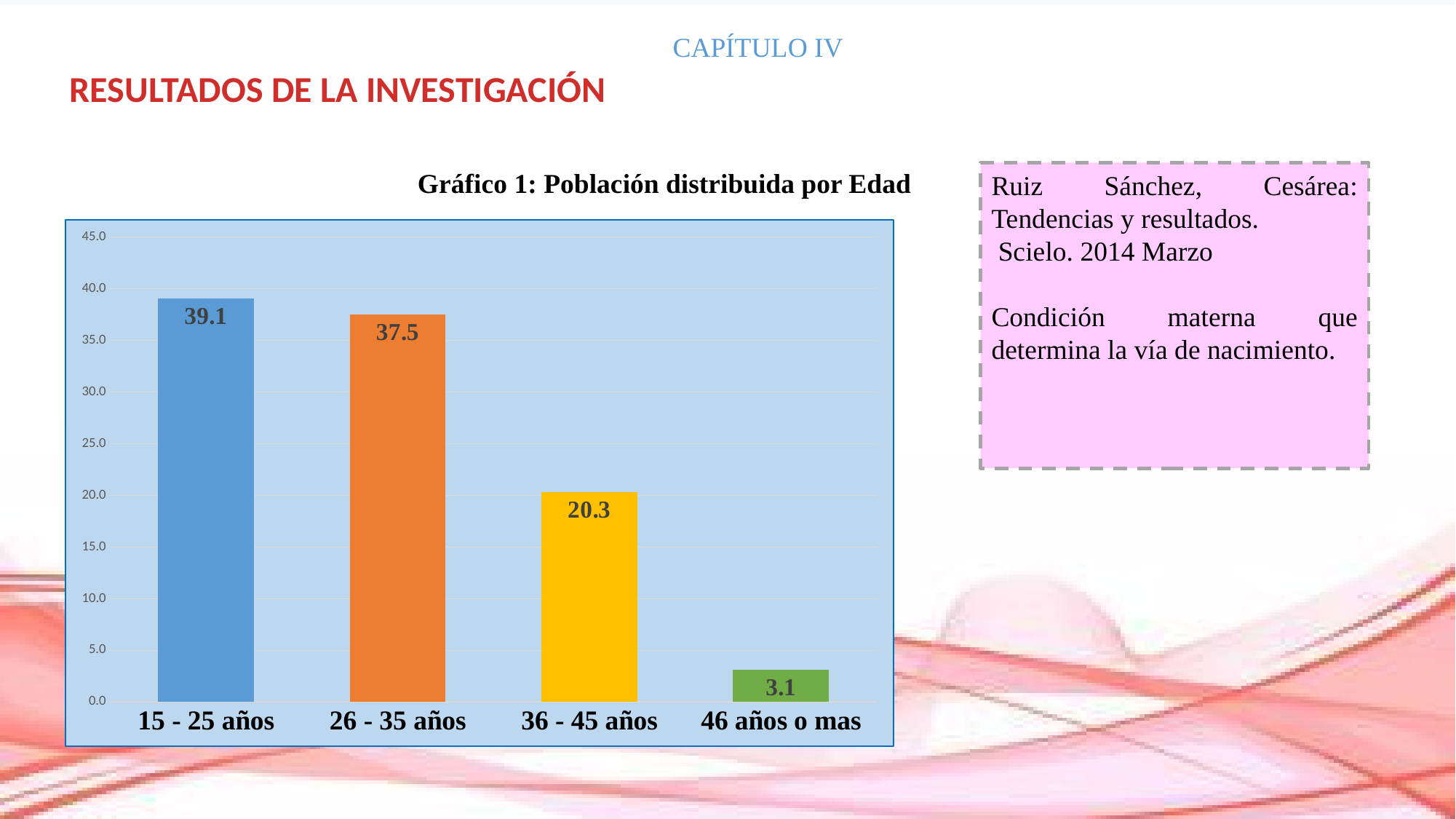
How many age categories are shown in the chart? 4 What is the difference between the values for 36 - 45 años and 46 años o mas? 17.2 What is the difference between the values for 15 - 25 años and 26 - 35 años? 1.6 Which age category has the lowest value? 46 años o mas What kind of chart is shown on the slide? Bar chart What is the title of the chart? Gráfico 1: Población distribuida por Edad Which is larger, the value for 26 - 35 años or the value for 36 - 45 años? 26 - 35 años What is the value for the 36 - 45 años category? 20.3 What is the value for the 26 - 35 años category? 37.5 What is the value for the 46 años o mas category? 3.1 Which age category has the highest value? 15 - 25 años What is the value for the 15 - 25 años category? 39.1